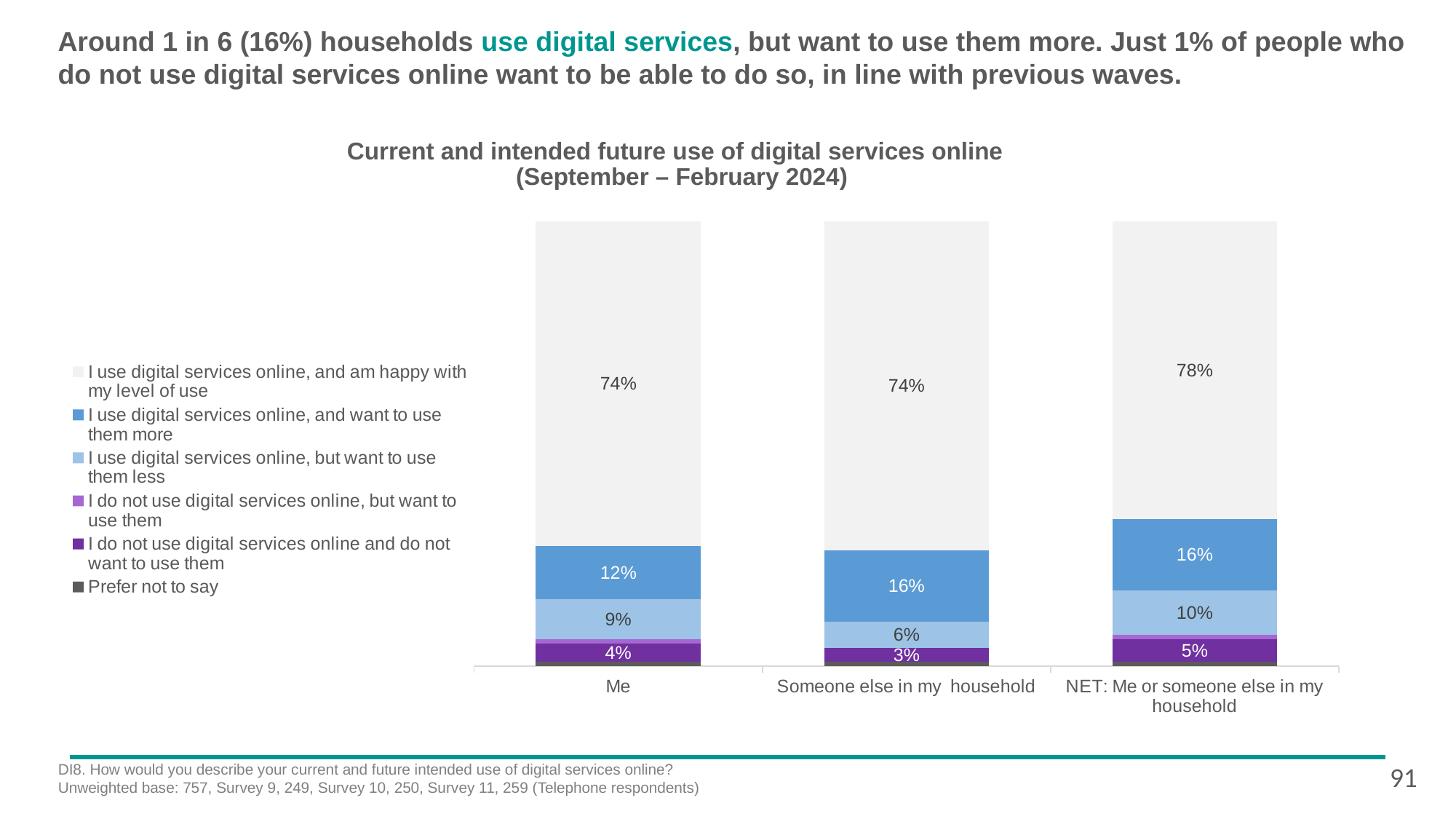
What is the value for 'I use digital services online, and want to use them more' in the 'Someone else in my household' bar? 16% What percentage of the 'Me' bar is 'I use digital services online, and am happy with my level of use'? 74% What is the difference between the 'I use digital services online, and want to use them more' values for 'Someone else in my household' and 'Me'? 4 percentage points How many series does the legend list? 6 Which category has the highest value for 'I use digital services online, and am happy with my level of use'? NET: Me or someone else in my household What kind of chart is shown on the slide? Stacked bar chart What is the value for 'I use digital services online, and want to use them more' in the 'Me' bar? 12% Which is larger: the 'I use digital services online, but want to use them less' value for 'Me' or for 'Someone else in my household'? Me What is the value for 'I use digital services online, but want to use them less' in the 'NET: Me or someone else in my household' bar? 10% Which category has the lowest value for 'I use digital services online, but want to use them less'? Someone else in my household How many categories are shown along the x axis of the chart? 3 What is the title of the chart? Current and intended future use of digital services online (September – February 2024)